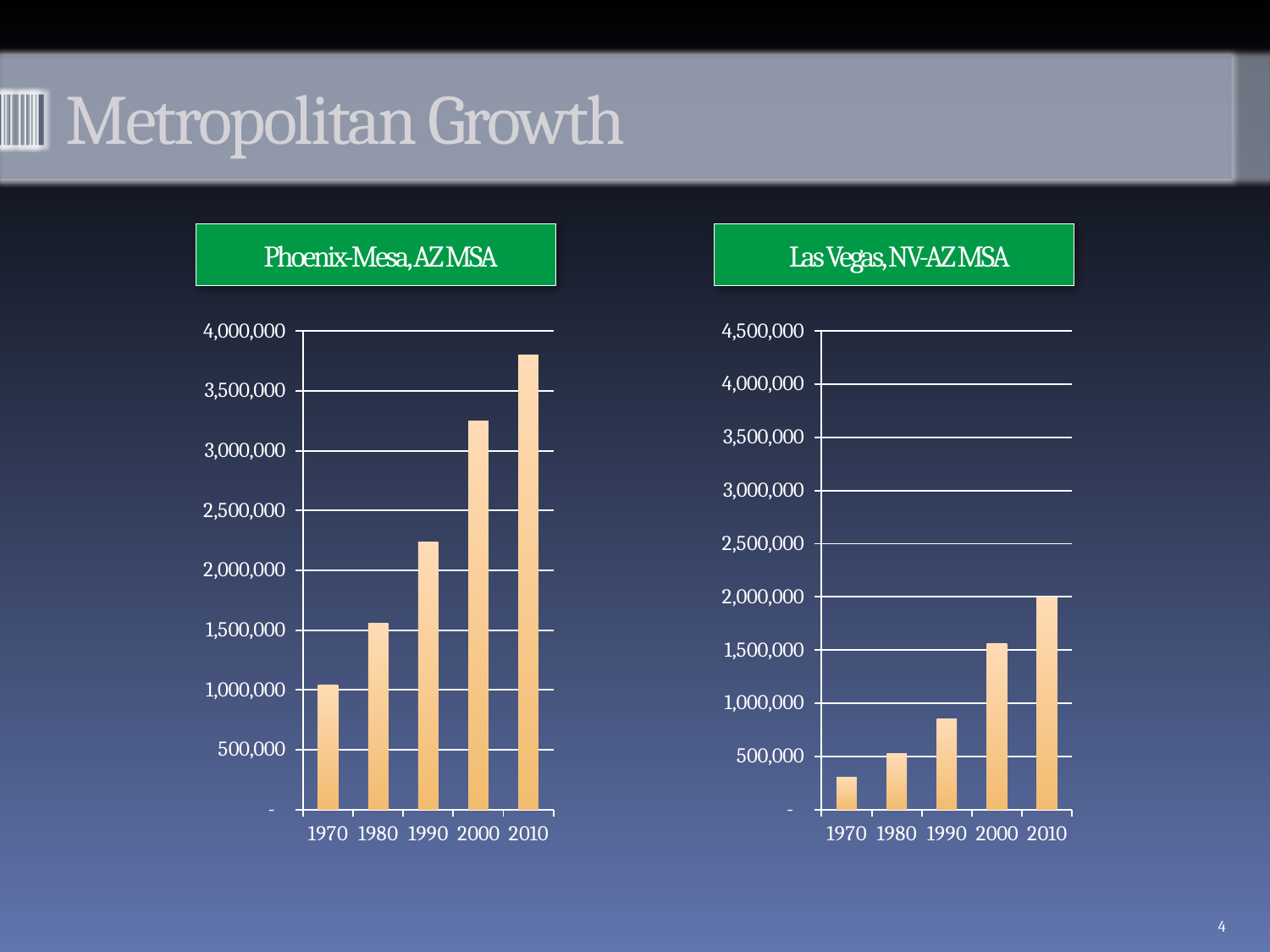
In the Las Vegas, NV-AZ MSA chart, is the value for 1990 greater or less than 1,000,000? less In the Phoenix-Mesa, AZ MSA chart, is the value for 1990 greater or less than 2,000,000? greater In the Las Vegas, NV-AZ MSA chart, which is larger, the value for 2000 or the value for 1980? 2000 In the Phoenix-Mesa, AZ MSA chart, which year has the highest value? 2010 In the Las Vegas, NV-AZ MSA chart, which year has the lowest value? 1970 What kind of chart is the Phoenix-Mesa, AZ MSA chart? bar chart In the Phoenix-Mesa, AZ MSA chart, is the value for 2010 greater or less than 3,500,000? greater How many years are shown on the x axis of the Las Vegas, NV-AZ MSA chart? 5 What is the title of the chart on the right side of the slide? Las Vegas, NV-AZ MSA In the Phoenix-Mesa, AZ MSA chart, do the values rise or fall from 1970 to 2010? rise